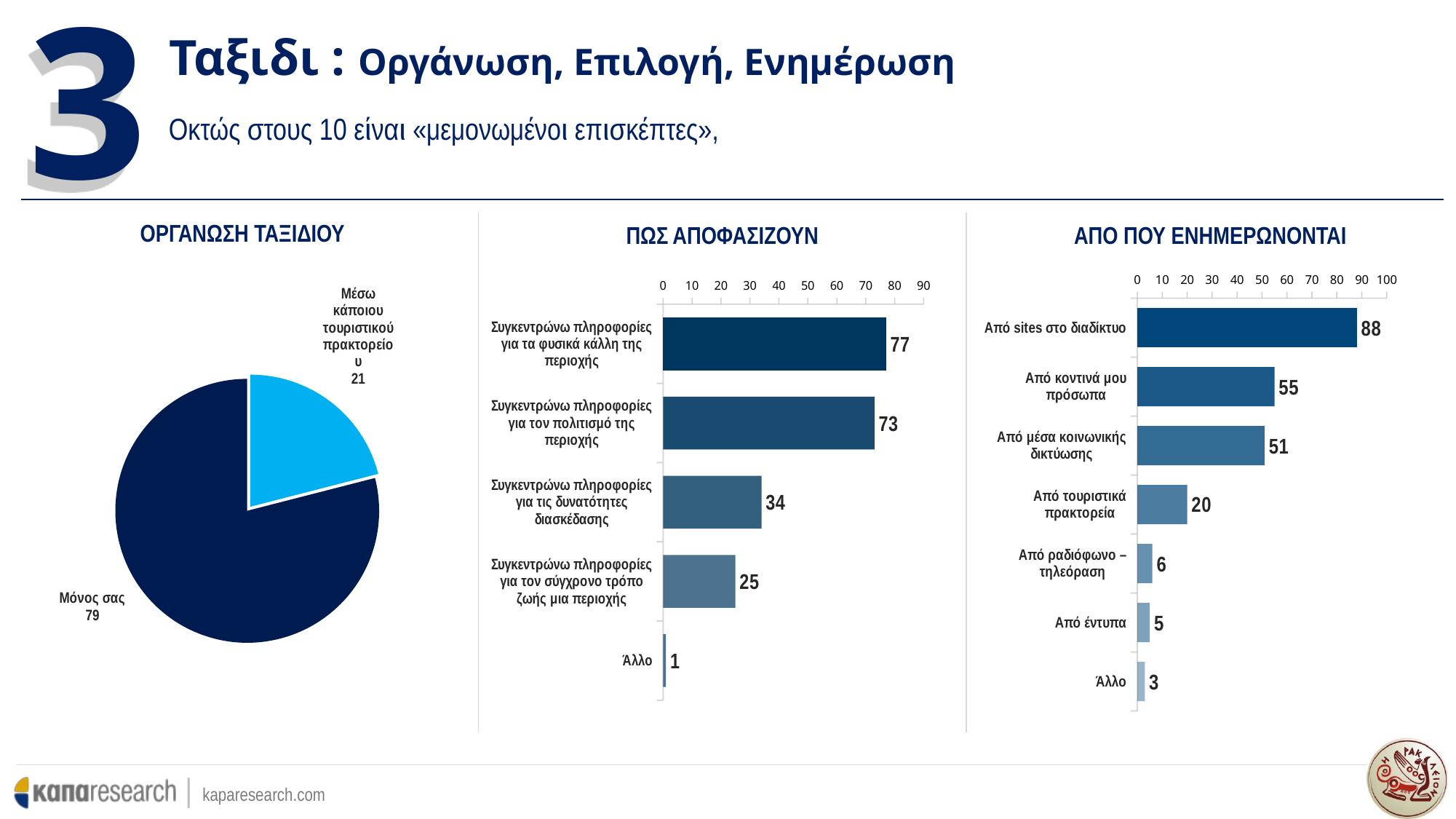
In the chart titled ΑΠΟ ΠΟΥ ΕΝΗΜΕΡΩΝΟΝΤΑΙ, what kind of chart is shown? Bar chart In the chart titled ΑΠΟ ΠΟΥ ΕΝΗΜΕΡΩΝΟΝΤΑΙ, which category has the lowest value? Άλλο In the chart titled ΑΠΟ ΠΟΥ ΕΝΗΜΕΡΩΝΟΝΤΑΙ, what is the difference between the values for Από sites στο διαδίκτυο and Από τουριστικά πρακτορεία? 68 In the chart titled ΠΩΣ ΑΠΟΦΑΣΙΖΟΥΝ, what is the difference between the values for Συγκεντρώνω πληροφορίες για τις δυνατότητες διασκέδασης and Συγκεντρώνω πληροφορίες για τον σύγχρονο τρόπο ζωής μια περιοχής? 9 In the chart titled ΑΠΟ ΠΟΥ ΕΝΗΜΕΡΩΝΟΝΤΑΙ, which is larger: Από κοντινά μου πρόσωπα or Από μέσα κοινωνικής δικτύωσης? Από κοντινά μου πρόσωπα In the chart titled ΠΩΣ ΑΠΟΦΑΣΙΖΟΥΝ, which category has the highest value? Συγκεντρώνω πληροφορίες για τα φυσικά κάλλη της περιοχής In the chart titled ΠΩΣ ΑΠΟΦΑΣΙΖΟΥΝ, how many categories are plotted? 5 In the chart titled ΠΩΣ ΑΠΟΦΑΣΙΖΟΥΝ, what is the value for Συγκεντρώνω πληροφορίες για τον πολιτισμό της περιοχής? 73 In the chart titled ΑΠΟ ΠΟΥ ΕΝΗΜΕΡΩΝΟΝΤΑΙ, what is the value for Από sites στο διαδίκτυο? 88 In the chart titled ΟΡΓΑΝΩΣΗ ΤΑΞΙΔΙΟΥ, what kind of chart is shown? Pie chart In the chart titled ΟΡΓΑΝΩΣΗ ΤΑΞΙΔΙΟΥ, how many slices does the pie have? 2 In the chart titled ΟΡΓΑΝΩΣΗ ΤΑΞΙΔΙΟΥ, what is the value for Μόνος σας? 79